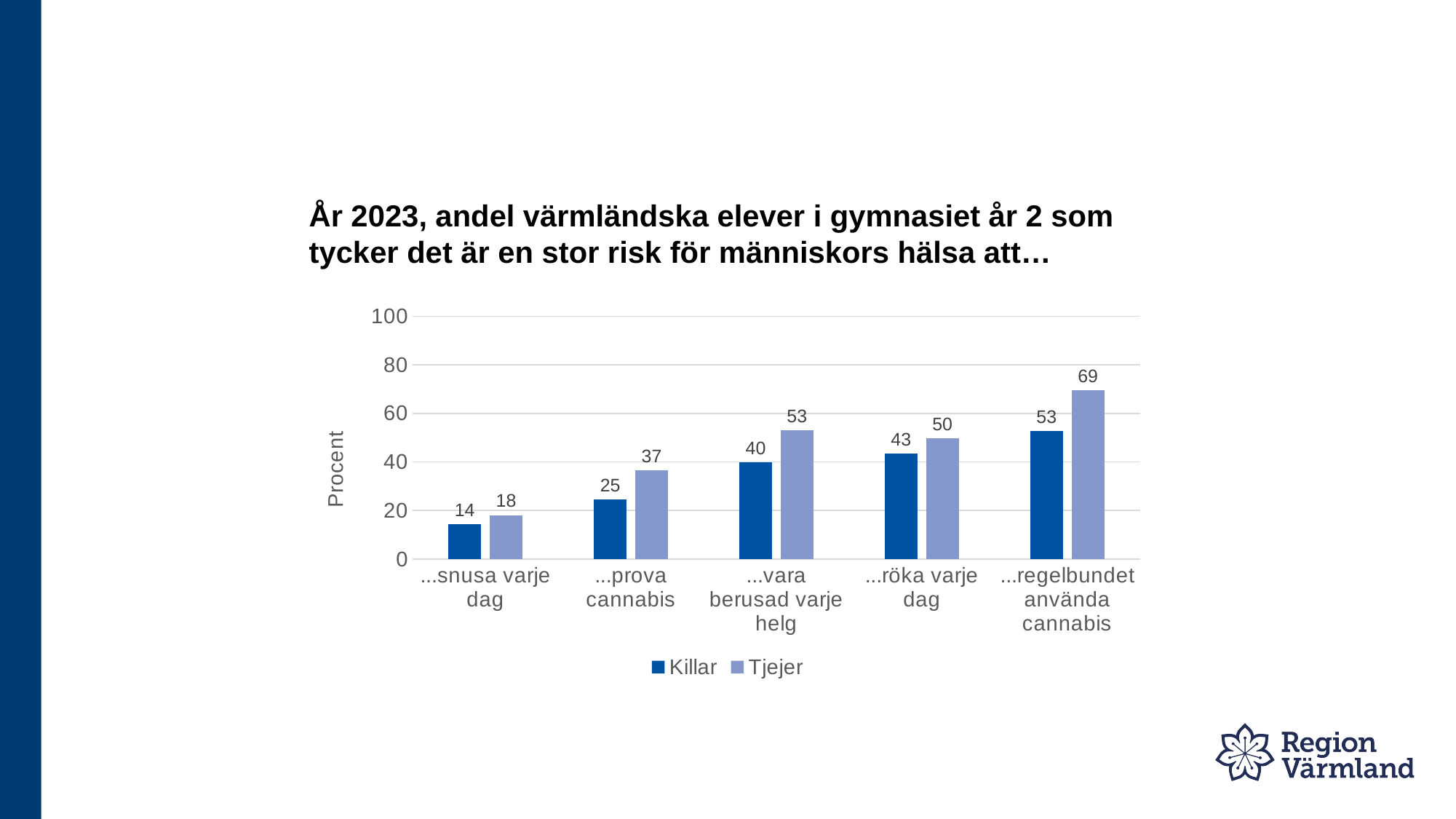
Is the value for Tjejer for "...regelbundet använda cannabis" greater or less than 60? greater What is the value for Tjejer for "...prova cannabis"? 37 Which is larger for "...röka varje dag": Killar or Tjejer? Tjejer What is the value for Tjejer for "...regelbundet använda cannabis"? 69 Which category has the lowest value for Killar? ...snusa varje dag What is the difference between Tjejer and Killar for "...vara berusad varje helg"? 13 How many categories are shown on the x axis? 5 What is the label of the y axis? Procent What kind of chart is shown on the slide? Bar chart How many series does the legend list? 2 Which category has the highest value for Tjejer? ...regelbundet använda cannabis What is the value for Killar for "...snusa varje dag"? 14